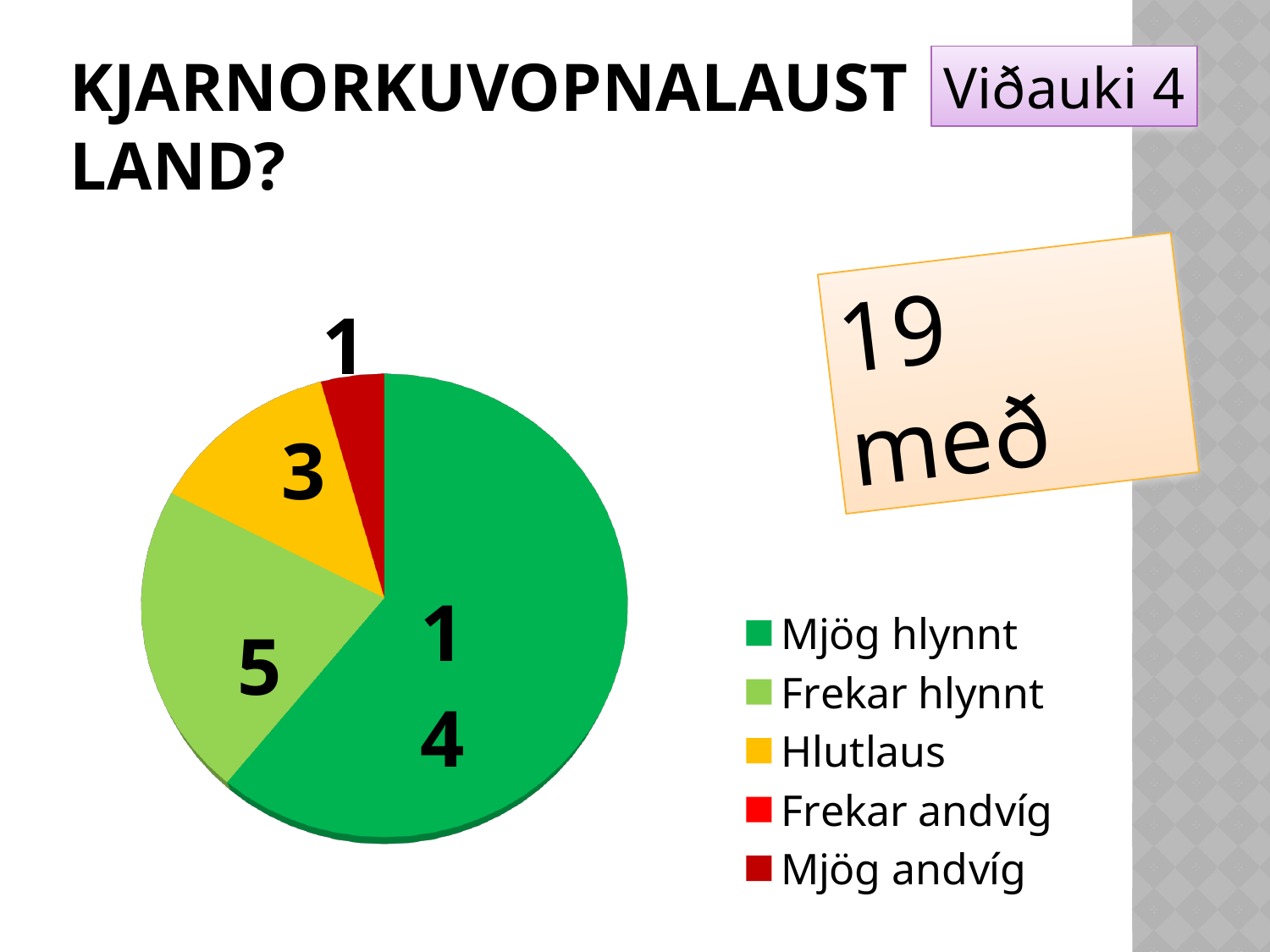
Of the slices shown in the pie chart, which category has the smallest? Mjög andvíg What is the value for Frekar hlynnt in the pie chart? 5 What is the difference between the values for Mjög hlynnt and Frekar hlynnt? 9 Which is larger, the value for Hlutlaus or the value for Frekar hlynnt? Frekar hlynnt How many categories does the legend list? 5 Which category has the largest slice in the pie chart? Mjög hlynnt What kind of chart is shown on the slide? pie chart What is the value for Mjög hlynnt in the pie chart? 14 What colour is the Hlutlaus slice in the pie chart? yellow What is the value for Hlutlaus in the pie chart? 3 What is the total of all the values labelled on the pie chart? 23 What is the value for Mjög andvíg in the pie chart? 1